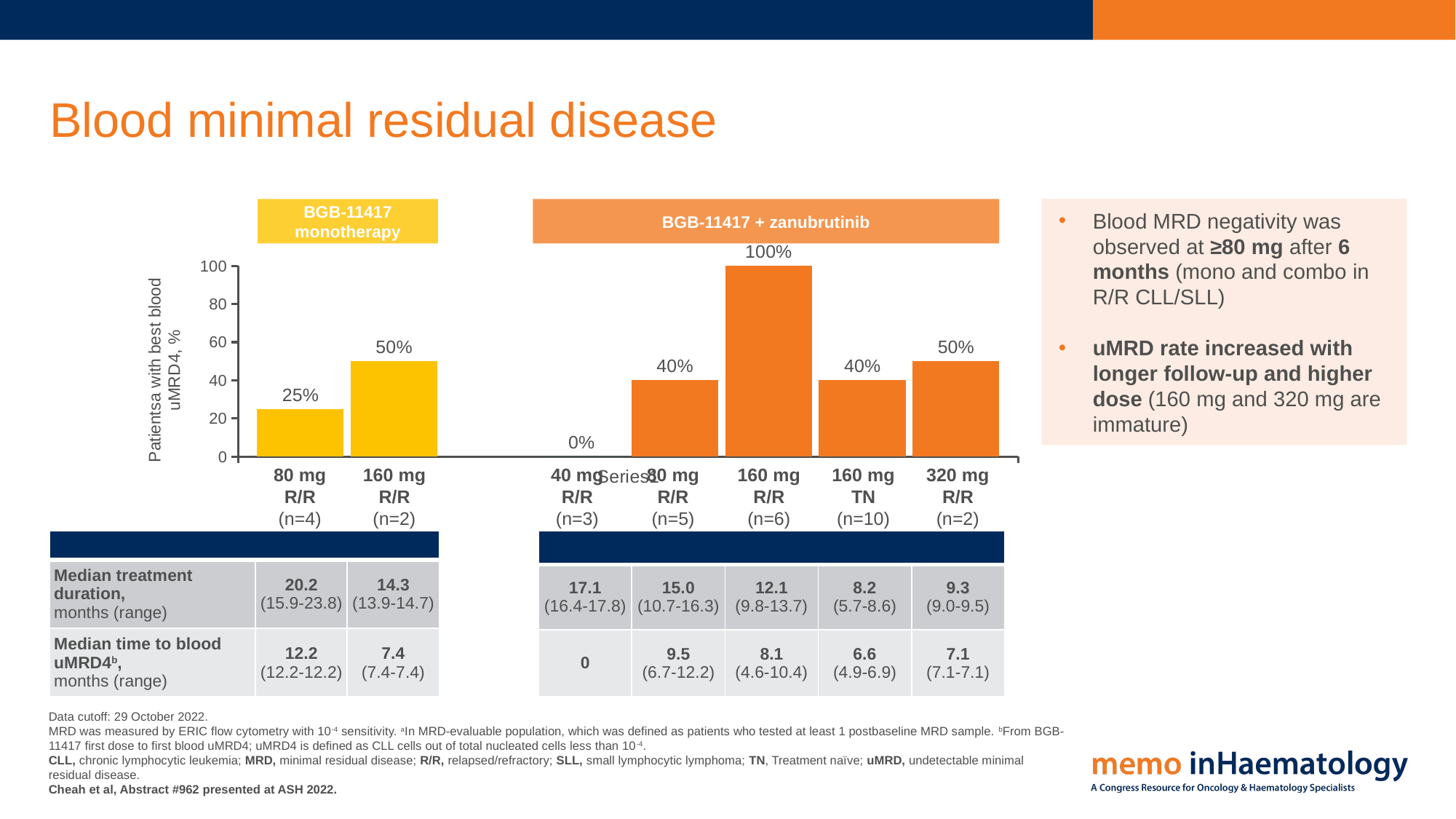
What type of chart is used to show the uMRD4 rates? Bar chart Which has a higher uMRD4 rate: the 80 mg R/R cohort in the monotherapy group or the 80 mg R/R cohort in the BGB-11417 + zanubrutinib group? 80 mg R/R in the BGB-11417 + zanubrutinib group How many cohorts (bars) are plotted on the chart in total? 7 Which cohort has the highest uMRD4 rate on the chart? 160 mg R/R (BGB-11417 + zanubrutinib) What is the uMRD4 rate for the 80 mg R/R cohort in the BGB-11417 monotherapy group? 25% What is the uMRD4 rate for the 160 mg R/R cohort in the BGB-11417 + zanubrutinib group? 100% How many cohorts are shown in the BGB-11417 + zanubrutinib group? 5 What is the uMRD4 rate for the 160 mg TN cohort in the BGB-11417 + zanubrutinib group? 40% What is the label of the y-axis on the chart? Patients with best blood uMRD4, % What is the uMRD4 rate for the 40 mg R/R cohort in the BGB-11417 + zanubrutinib group? 0% Which cohort has the lowest uMRD4 rate on the chart? 40 mg R/R (BGB-11417 + zanubrutinib) What is the difference in uMRD4 rate between the 160 mg R/R and 80 mg R/R cohorts in the BGB-11417 monotherapy group? 25%